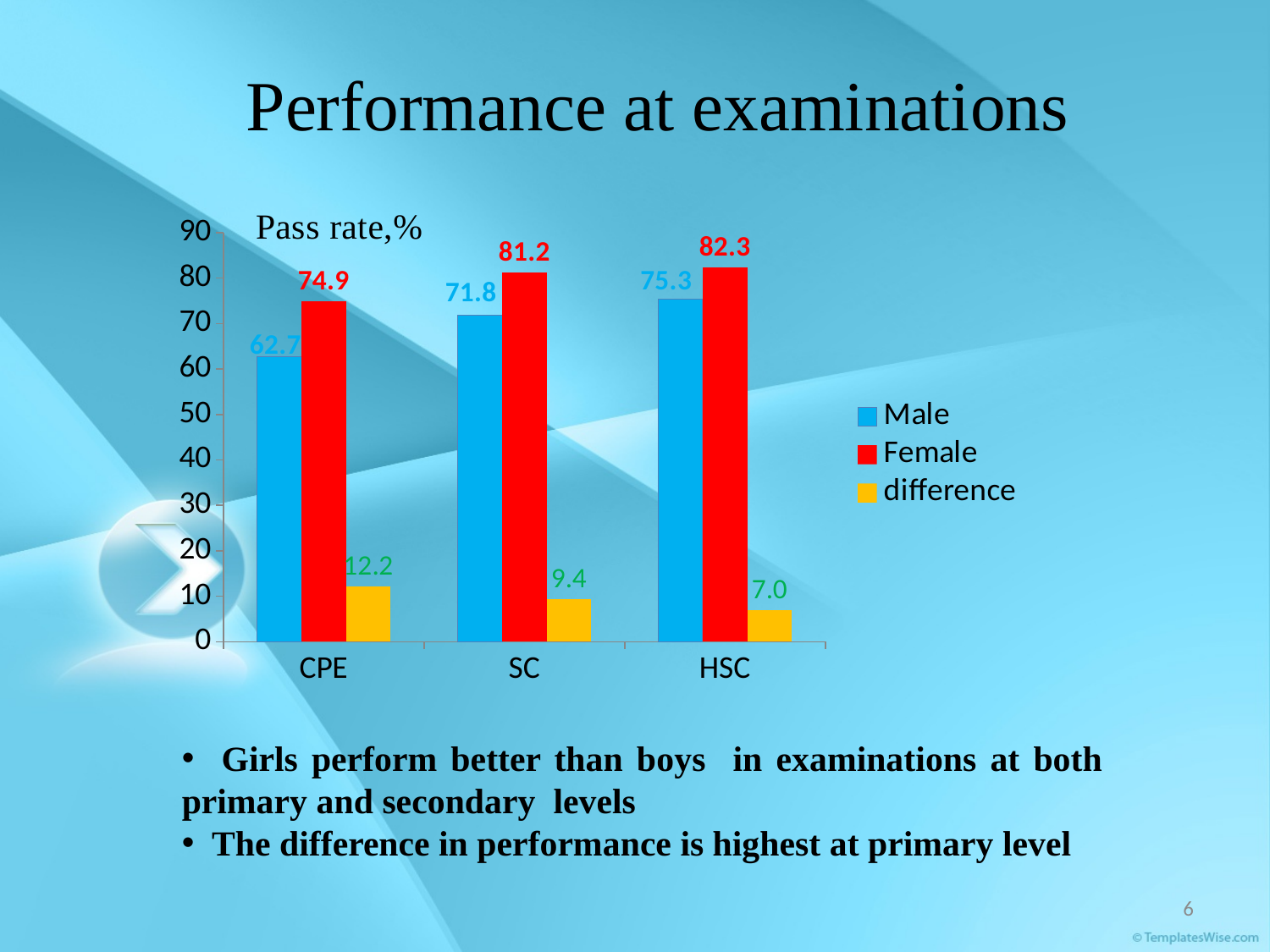
What is the difference value shown for HSC? 7.0 What is the Male pass rate for CPE? 62.7 What is the difference between the Female and Male pass rates for SC? 9.4 How many examination categories are shown on the x axis? 3 Which is larger, the Male pass rate for HSC or the Male pass rate for SC? Male pass rate for HSC Does the difference series rise or fall from CPE to HSC? fall Which examination has the highest Female pass rate? HSC Is the Female pass rate for CPE greater or less than 70? greater What kind of chart is shown on the slide? bar chart Which examination has the lowest Male pass rate? CPE How many series does the legend list? 3 What is the Female pass rate for SC? 81.2